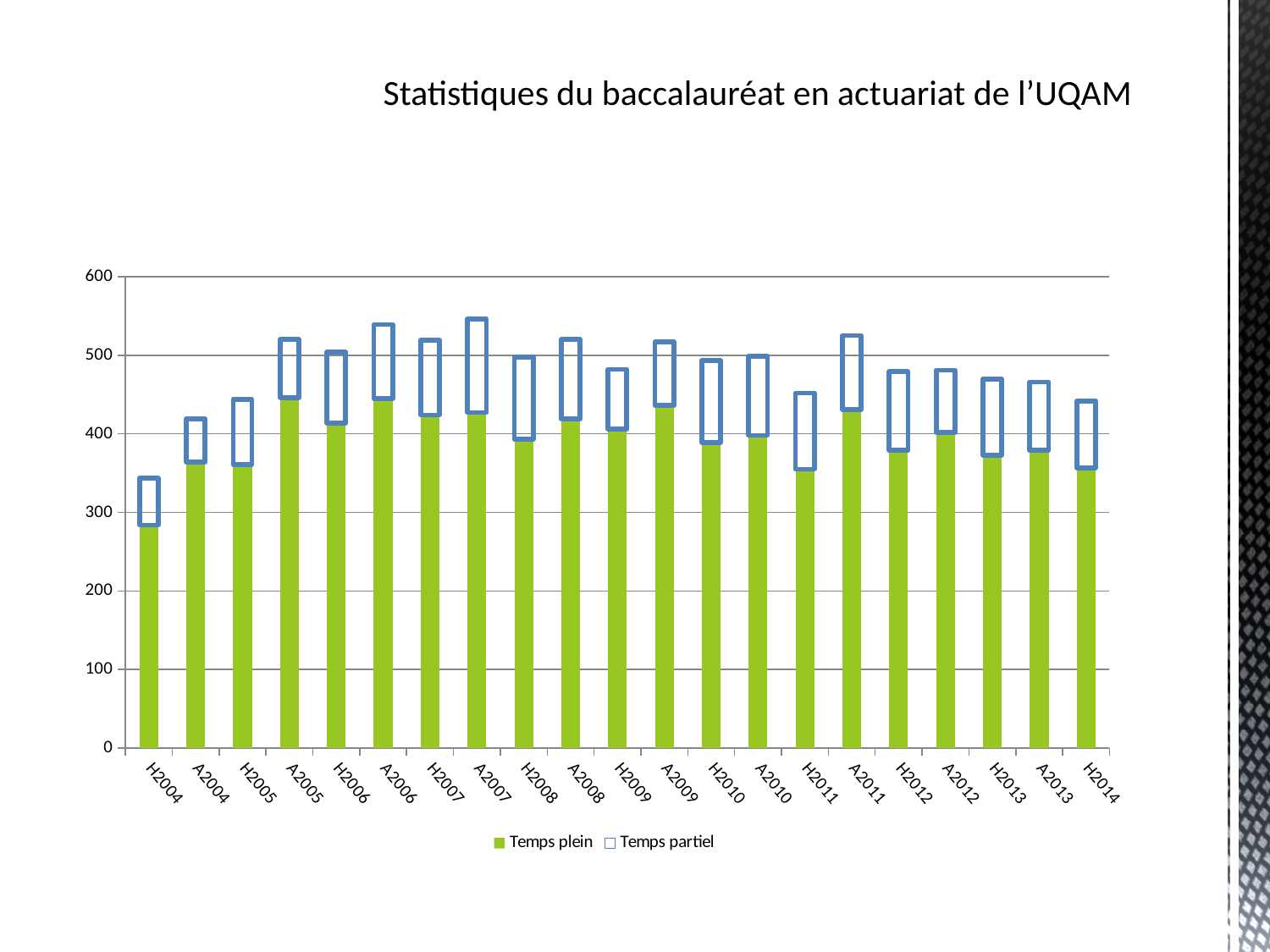
Is the total of the stacked bar for A2007 greater or less than 500? greater Which has the larger Temps plein value, H2011 or A2011? A2011 Do the Temps plein values rise or fall from H2004 to A2005? rise What are the two series named in the legend? Temps plein and Temps partiel What kind of chart is shown on the slide? Bar chart What is the title of the slide? Statistiques du baccalauréat en actuariat de l'UQAM Is the Temps plein value for A2005 greater or less than 400? greater Which category has the lowest Temps plein value? H2004 Is the Temps plein value for H2004 greater or less than 300? less How many categories (semesters) are shown on the x axis? 21 How many series does the legend list? 2 Which category has the lowest total (Temps plein plus Temps partiel)? H2004